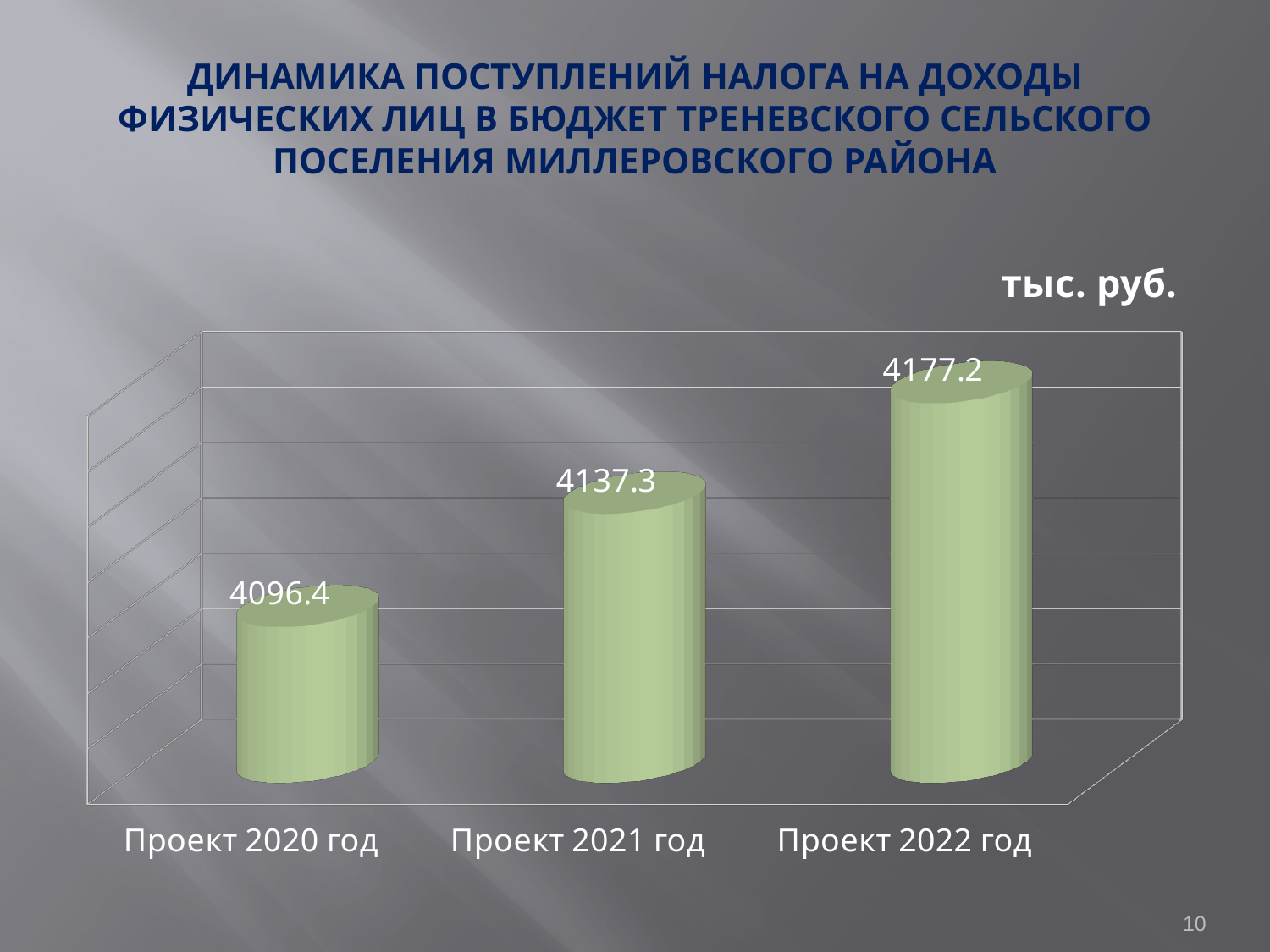
Which category has the lowest value? Проект 2020 год How many categories are shown in the chart? 3 What is the value for Проект 2020 год? 4096.4 What is the difference between the values for Проект 2021 год and Проект 2020 год? 40.9 Which is larger, the value for Проект 2021 год or Проект 2022 год? Проект 2022 год What is the value for Проект 2021 год? 4137.3 What is the value for Проект 2022 год? 4177.2 Which category has the highest value? Проект 2022 год Do the values rise or fall from Проект 2020 год to Проект 2022 год? Rise What kind of chart is shown on the slide? Bar chart What is the difference between the values for Проект 2022 год and Проект 2020 год? 80.8 What unit is indicated for the chart values? тыс. руб.